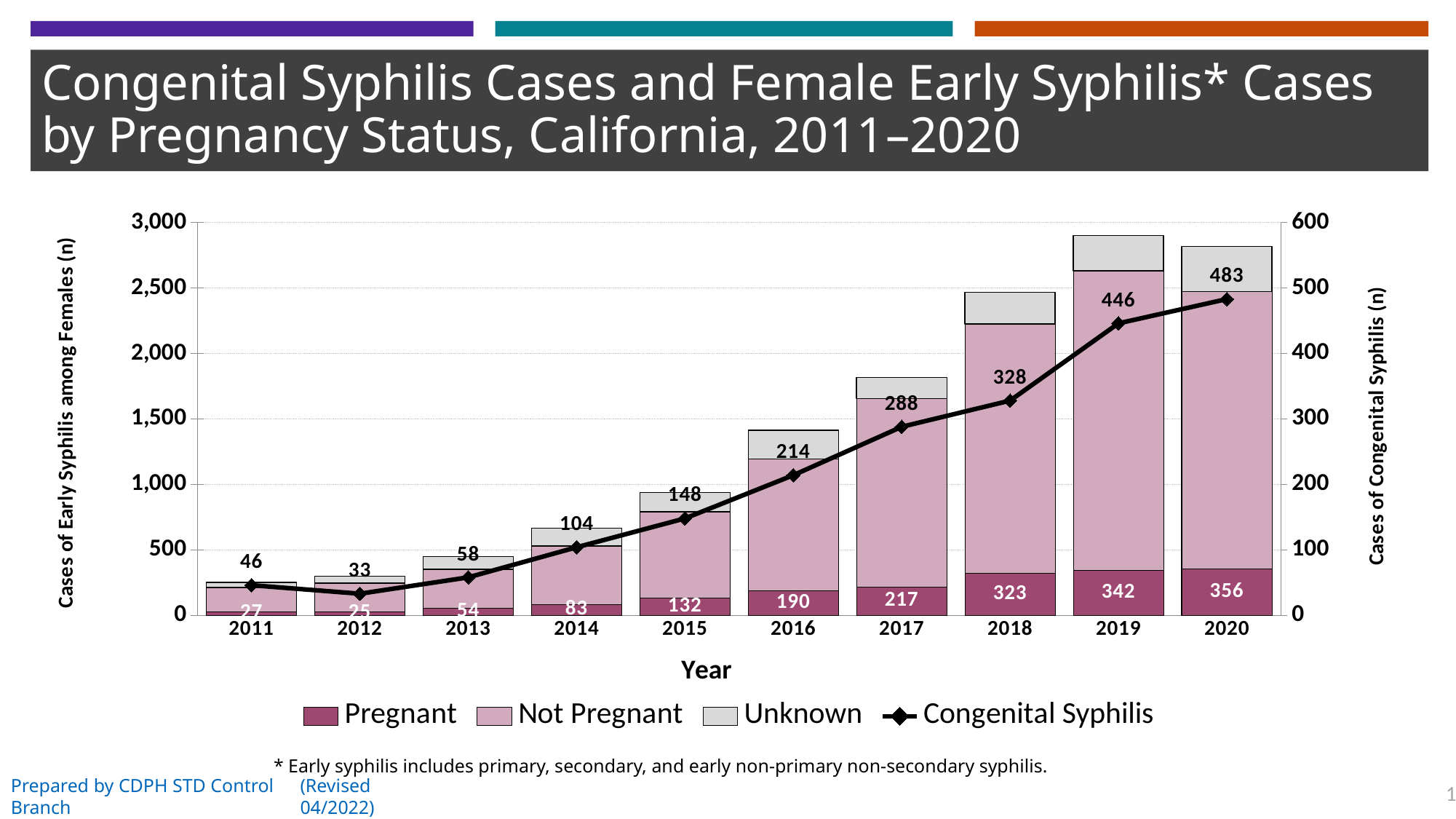
Which year has the lowest number of congenital syphilis cases? 2012 Which is larger: the number of pregnant early syphilis cases in 2017 or the number of congenital syphilis cases in 2017? Congenital syphilis cases in 2017 (288) What is the overall trend in congenital syphilis cases from 2012 to 2020? Rising Which year has the highest number of early syphilis cases among pregnant females? 2020 Is the total number of early syphilis cases among females in 2019 greater or less than 2,500? greater How many congenital syphilis cases are shown for 2014? 104 How many years are shown on the x axis? 10 How many congenital syphilis cases are shown for 2020? 483 What is the label of the right-hand vertical axis? Cases of Congenital Syphilis (n) How many series does the legend list? 4 What is the difference in congenital syphilis cases between 2019 and 2018? 118 What is the number of early syphilis cases among pregnant females in 2018? 323